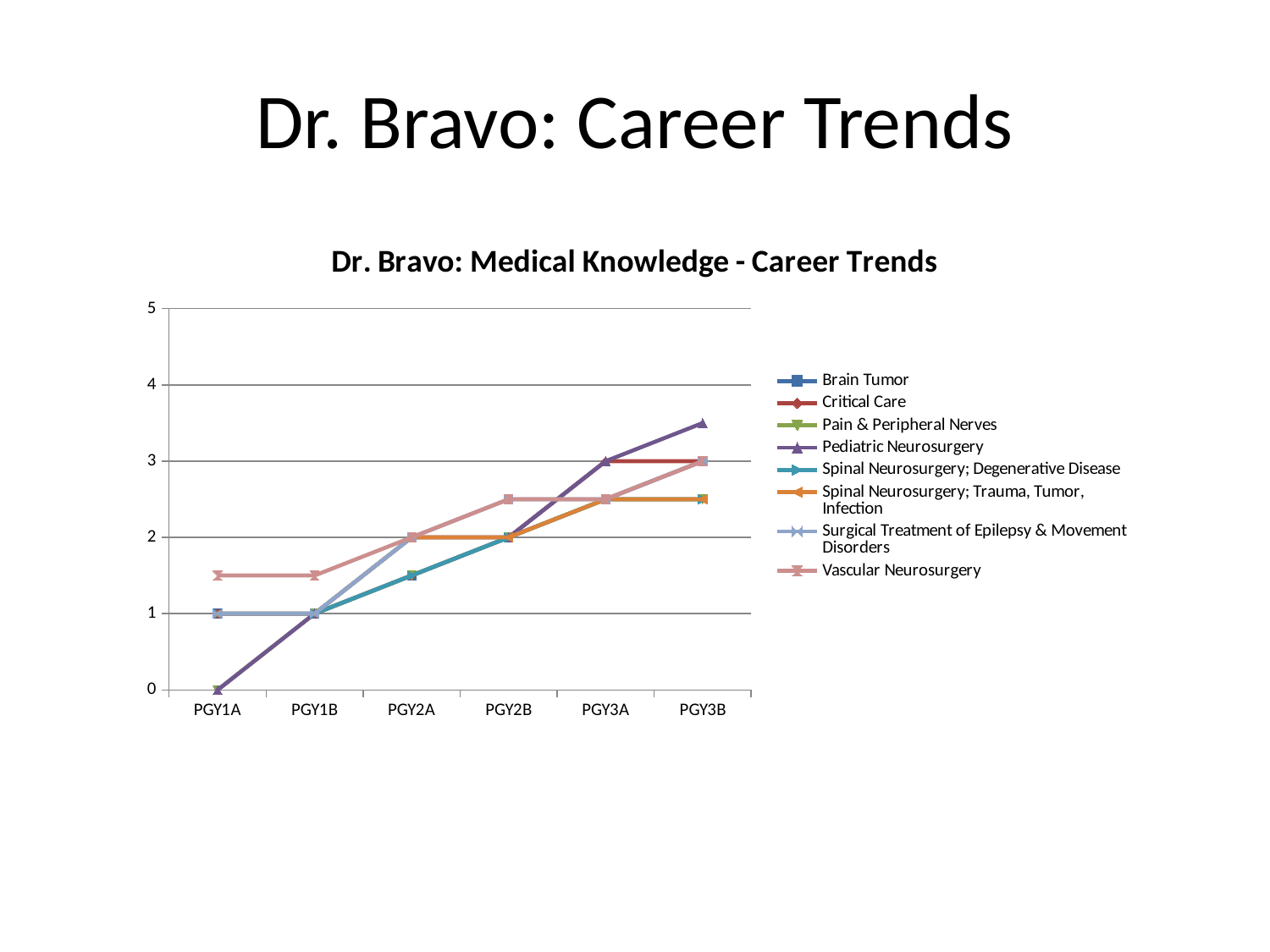
What is the title of the chart? Dr. Bravo: Medical Knowledge - Career Trends Is the value for Pediatric Neurosurgery at PGY3B greater or less than 3? greater How many series does the legend list? 8 What kind of chart is shown on the slide? line chart Which series has the highest value at PGY1A? Vascular Neurosurgery What is the value for Vascular Neurosurgery at PGY3B? 3 Which series has the highest value at PGY3B? Pediatric Neurosurgery What is the value for Pediatric Neurosurgery at PGY3A? 3 Does the Pediatric Neurosurgery series rise or fall from PGY1A to PGY3B? rise Is the value for Vascular Neurosurgery at PGY1A greater or less than 1? greater What is the value for Pediatric Neurosurgery at PGY1A? 0 How many categories are shown on the x axis? 6